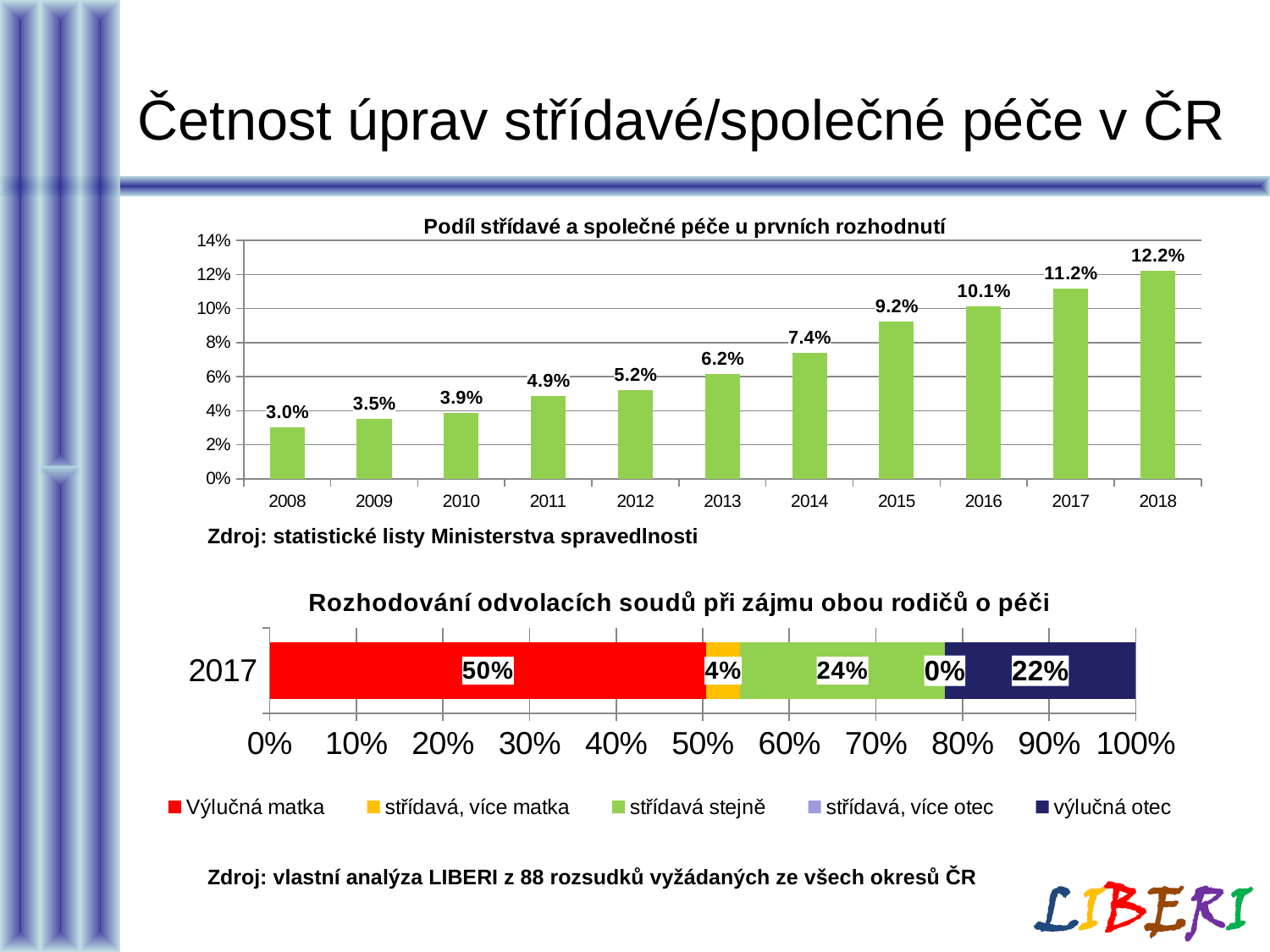
In the chart 'Podíl střídavé a společné péče u prvních rozhodnutí', what is the value for 2014? 7.4% In the chart 'Rozhodování odvolacích soudů při zájmu obou rodičů o péči', which is larger: 'střídavá stejně' or 'střídavá, více matka'? střídavá stejně In the chart 'Podíl střídavé a společné péče u prvních rozhodnutí', which year has the highest value? 2018 In the chart 'Rozhodování odvolacích soudů při zájmu obou rodičů o péči', how many series does the legend list? 6 In the chart 'Rozhodování odvolacích soudů při zájmu obou rodičů o péči', what is the value for 'Výlučná matka'? 50% In the chart 'Podíl střídavé a společné péče u prvních rozhodnutí', do the values rise or fall from 2008 to 2018? rise In the chart 'Rozhodování odvolacích soudů při zájmu obou rodičů o péči', what is the value for 'výlučná otec'? 22% In the chart 'Rozhodování odvolacích soudů při zájmu obou rodičů o péči', what colour represents 'Výlučná matka'? red In the chart 'Podíl střídavé a společné péče u prvních rozhodnutí', what is the difference between the values for 2018 and 2008? 9.2% What kind of chart is 'Podíl střídavé a společné péče u prvních rozhodnutí'? bar chart In the chart 'Podíl střídavé a společné péče u prvních rozhodnutí', which year has the lowest value? 2008 In the chart 'Podíl střídavé a společné péče u prvních rozhodnutí', how many years are shown on the x axis? 11